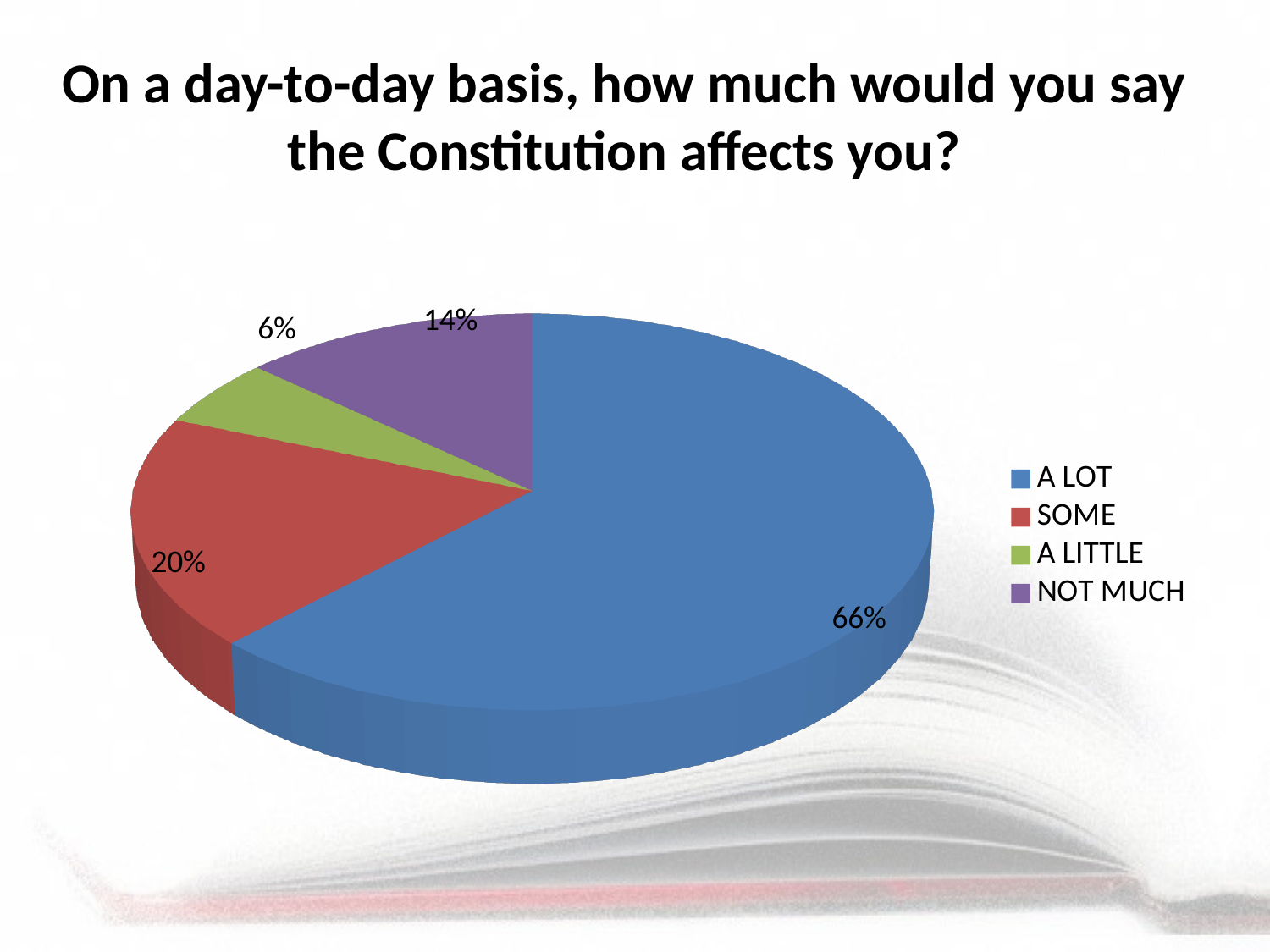
What share of the pie does A LITTLE take? 6% What is the difference in percentage points between NOT MUCH and A LITTLE? 8 What share of the pie does SOME take? 20% What is the difference in percentage points between A LOT and SOME? 46 Which category has the largest slice of the pie? A LOT What colour is the slice for A LITTLE? green How many categories does the legend list? 4 Which category has the smallest slice of the pie? A LITTLE What kind of chart is shown on the slide? pie chart What share of the pie does NOT MUCH take? 14% Which is larger, the slice for SOME or the slice for NOT MUCH? SOME